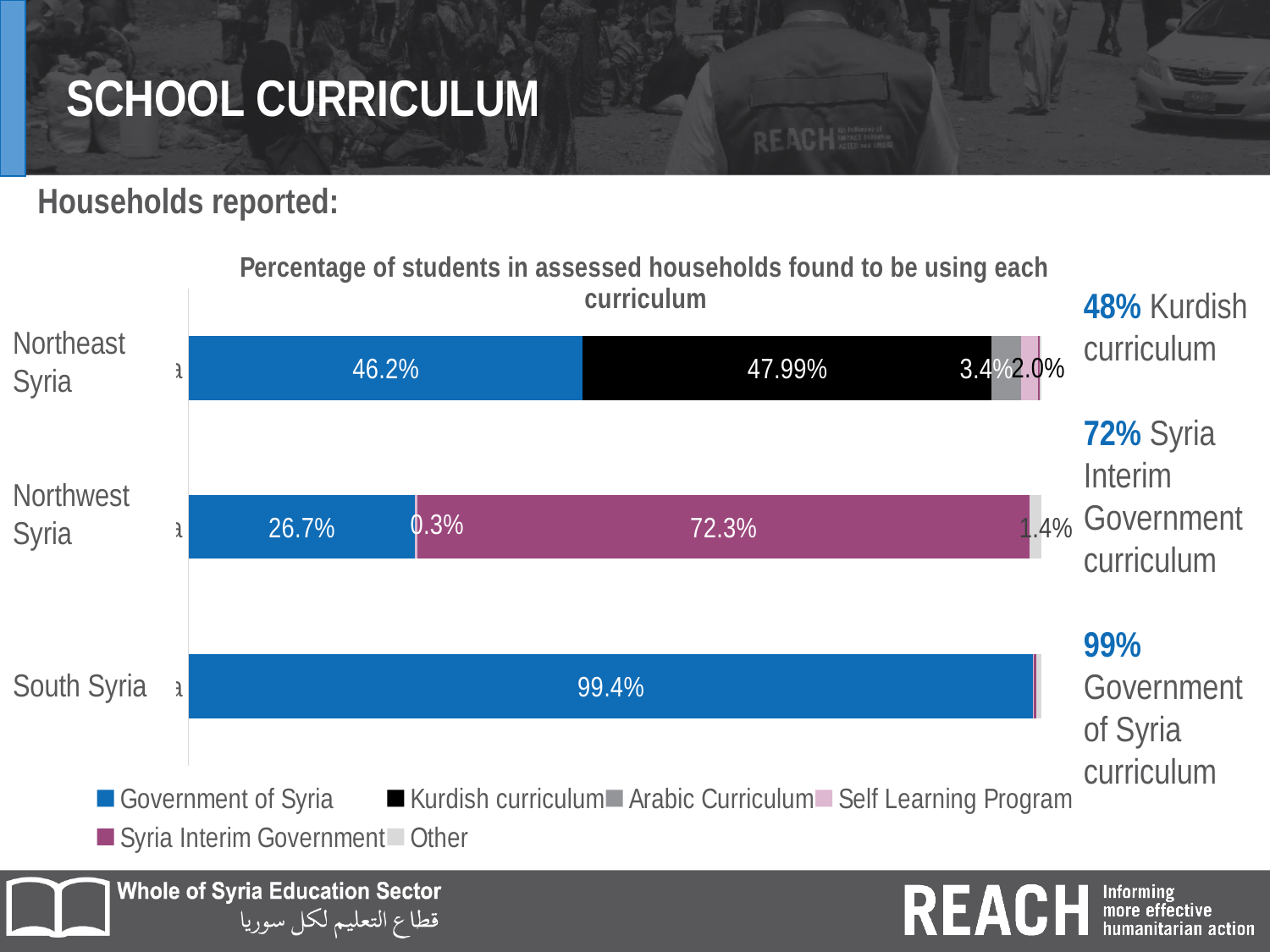
What percentage of students in Northwest Syria use the Syria Interim Government curriculum? 72.3% In Northeast Syria, which is larger: the share using the Kurdish curriculum or the share using the Government of Syria curriculum? Kurdish curriculum How many series does the legend list? 6 How many regions are shown on the chart? 3 What percentage of students in South Syria use the Government of Syria curriculum? 99.4% What type of chart is shown on the slide? Stacked bar chart What percentage of students in Northeast Syria use the Arabic Curriculum? 3.4% Which region has the highest share of students using the Government of Syria curriculum? South Syria What percentage of students in Northeast Syria use the Government of Syria curriculum? 46.2% What percentage of students in Northeast Syria use the Kurdish curriculum? 47.99% In Northeast Syria, what is the difference between the Kurdish curriculum share and the Government of Syria share? 1.79% What percentage of students in Northwest Syria use the Government of Syria curriculum? 26.7%